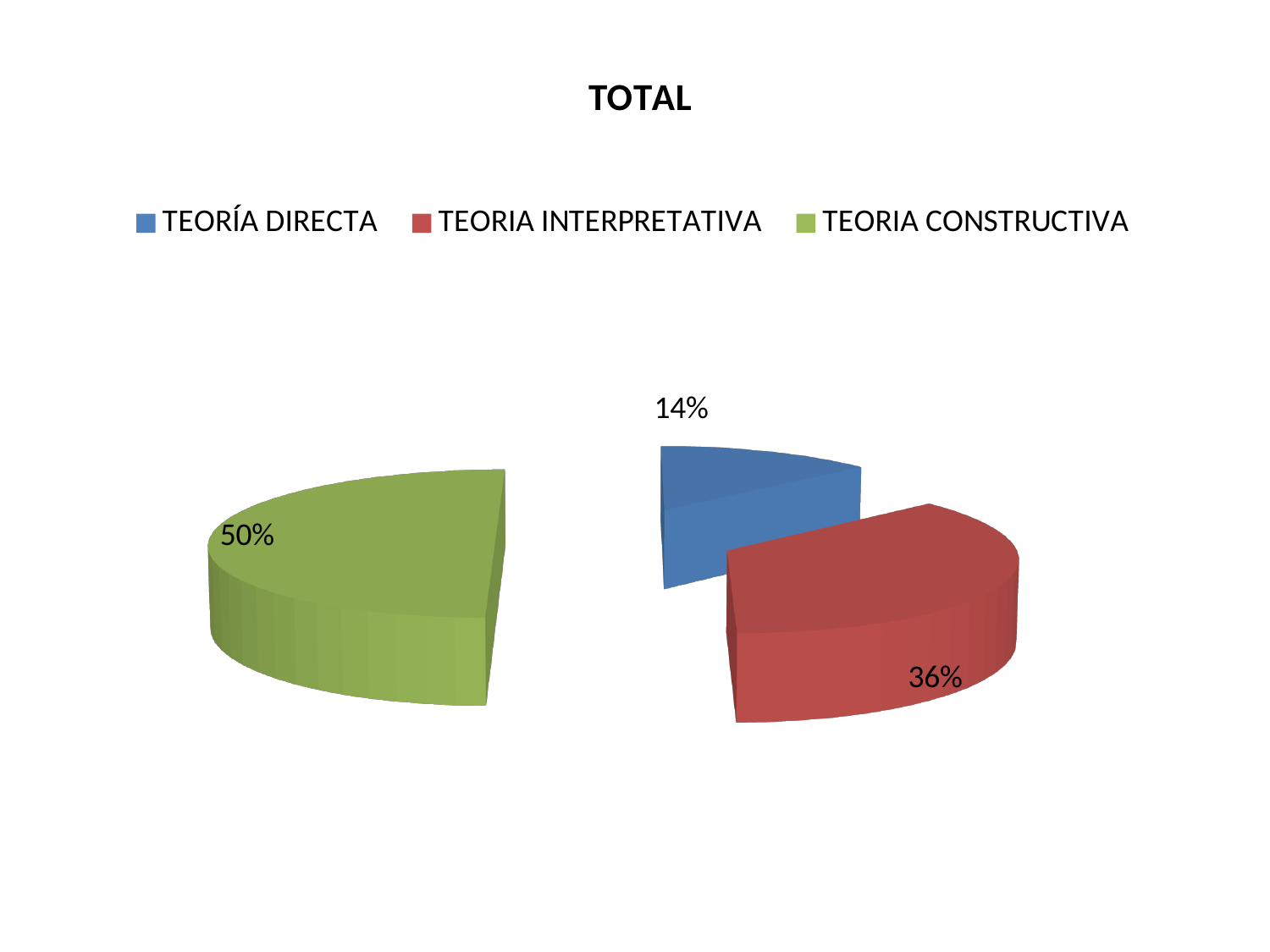
What is the difference in percentage points between TEORIA CONSTRUCTIVA and TEORIA INTERPRETATIVA? 14 What kind of chart is shown on the slide? pie chart Which category has the largest share of the pie? TEORIA CONSTRUCTIVA Which is larger, the share for TEORIA INTERPRETATIVA or the share for TEORÍA DIRECTA? TEORIA INTERPRETATIVA What percentage does TEORIA INTERPRETATIVA represent? 36% What percentage does TEORÍA DIRECTA represent? 14% How many categories does the legend list? 3 What is the title of the chart? TOTAL What percentage does TEORIA CONSTRUCTIVA represent? 50% What is the difference in percentage points between TEORIA INTERPRETATIVA and TEORÍA DIRECTA? 22 Which category has the smallest share of the pie? TEORÍA DIRECTA What colour is the slice for TEORIA CONSTRUCTIVA? green